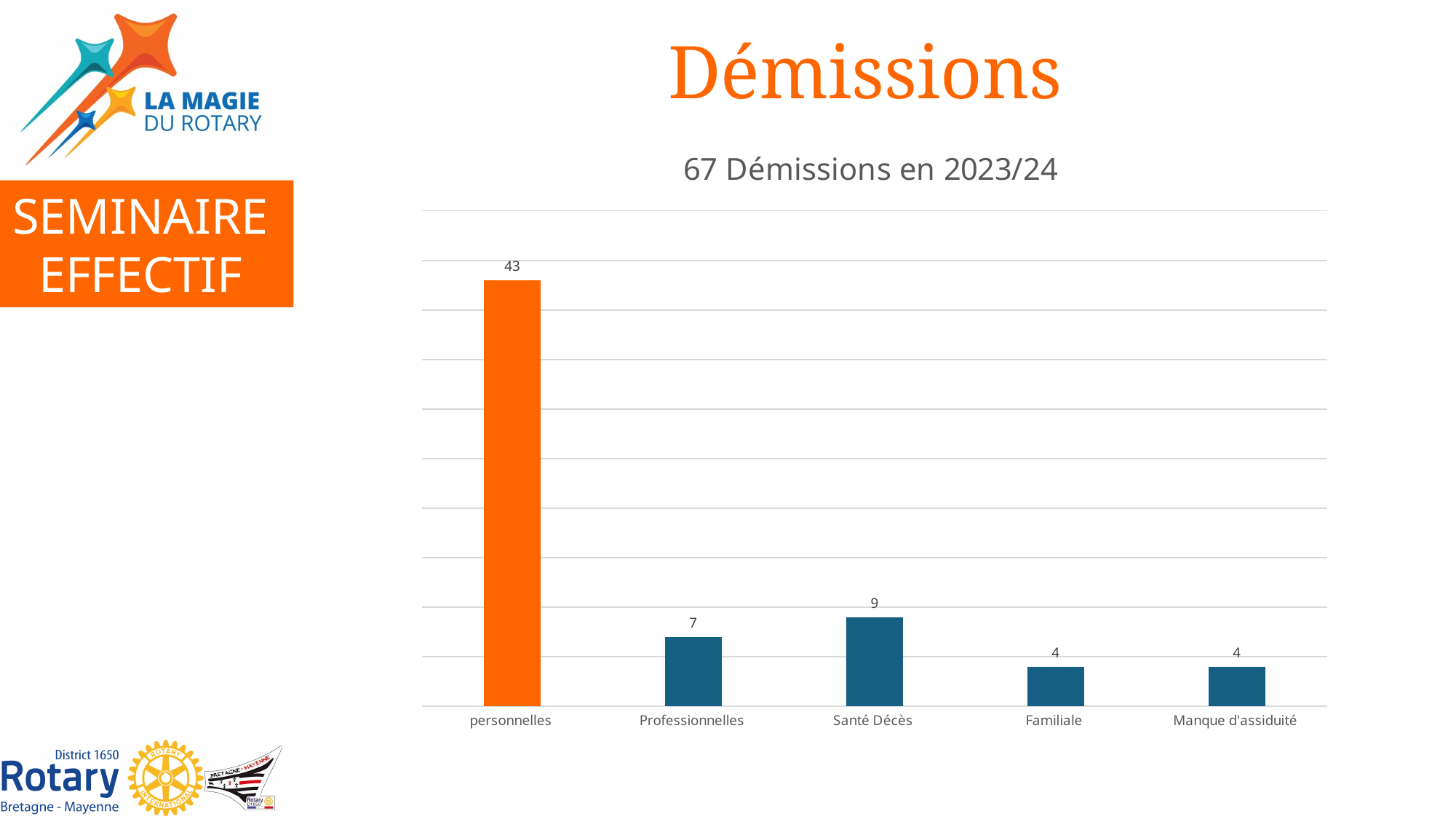
What is the value for personnelles? 43 How many categories are shown on the x axis? 5 Which is larger, the value for Professionnelles or the value for Santé Décès? Santé Décès What is the title of the chart? 67 Démissions en 2023/24 Which bar is coloured orange? personnelles Which category has the highest value? personnelles What is the difference between the values for Santé Décès and Professionnelles? 2 What kind of chart is shown? bar chart What is the value for Santé Décès? 9 What is the difference between the values for personnelles and Santé Décès? 34 What is the value for Professionnelles? 7 What is the value for Familiale? 4